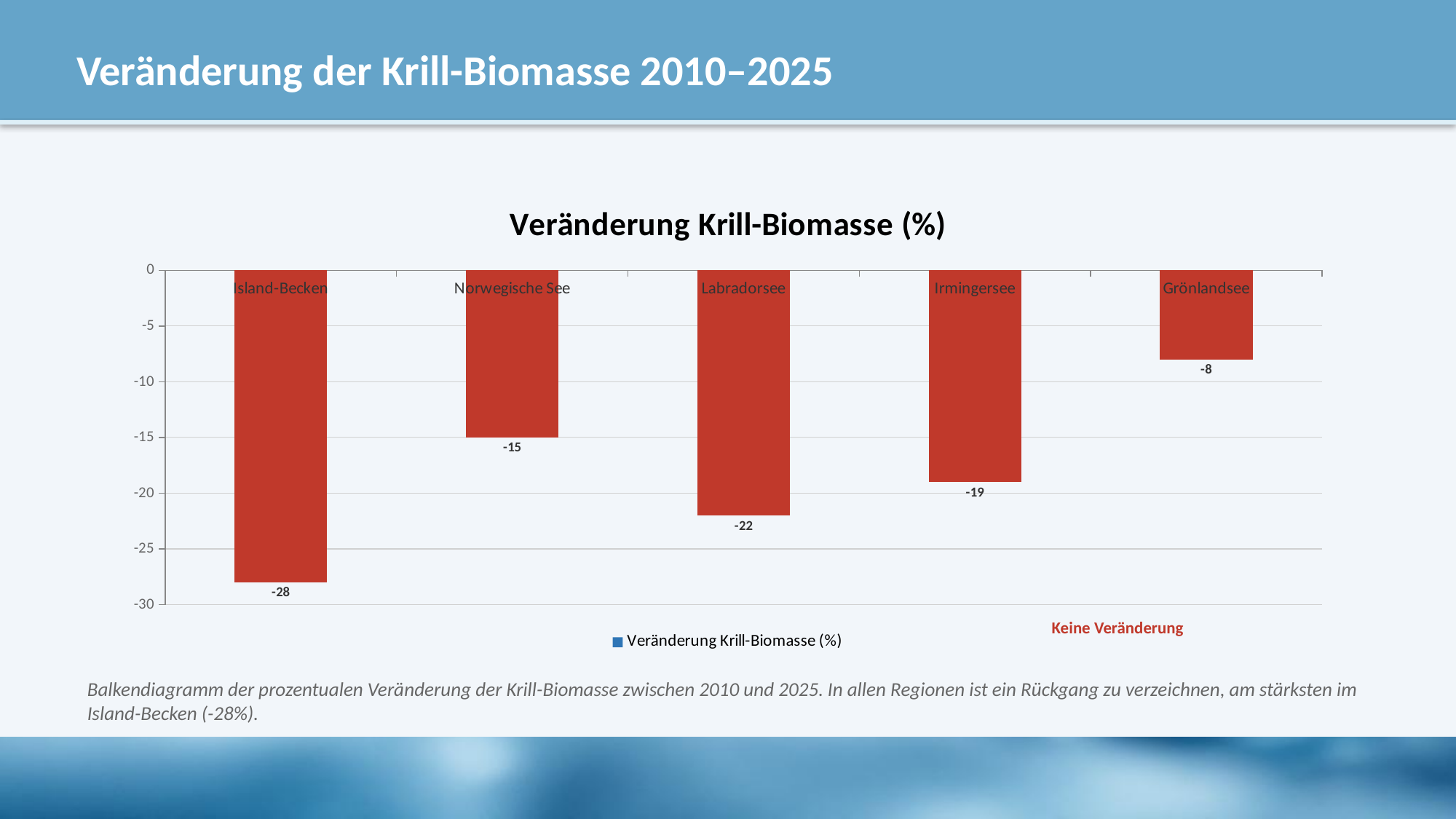
Which region has the lowest value (largest decline)? Island-Becken What is the value for Irmingersee? -19 What is the value for Grönlandsee? -8 Which region has the highest value (smallest decline)? Grönlandsee What is the value for Island-Becken? -28 What is the value for Norwegische See? -15 What kind of chart is shown? Bar chart What is the title of the chart? Veränderung Krill-Biomasse (%) How many regions are shown in the chart? 5 Which has the larger decline, Labradorsee or Irmingersee? Labradorsee What is the value for Labradorsee? -22 What is the difference between the values for Island-Becken and Grönlandsee? 20